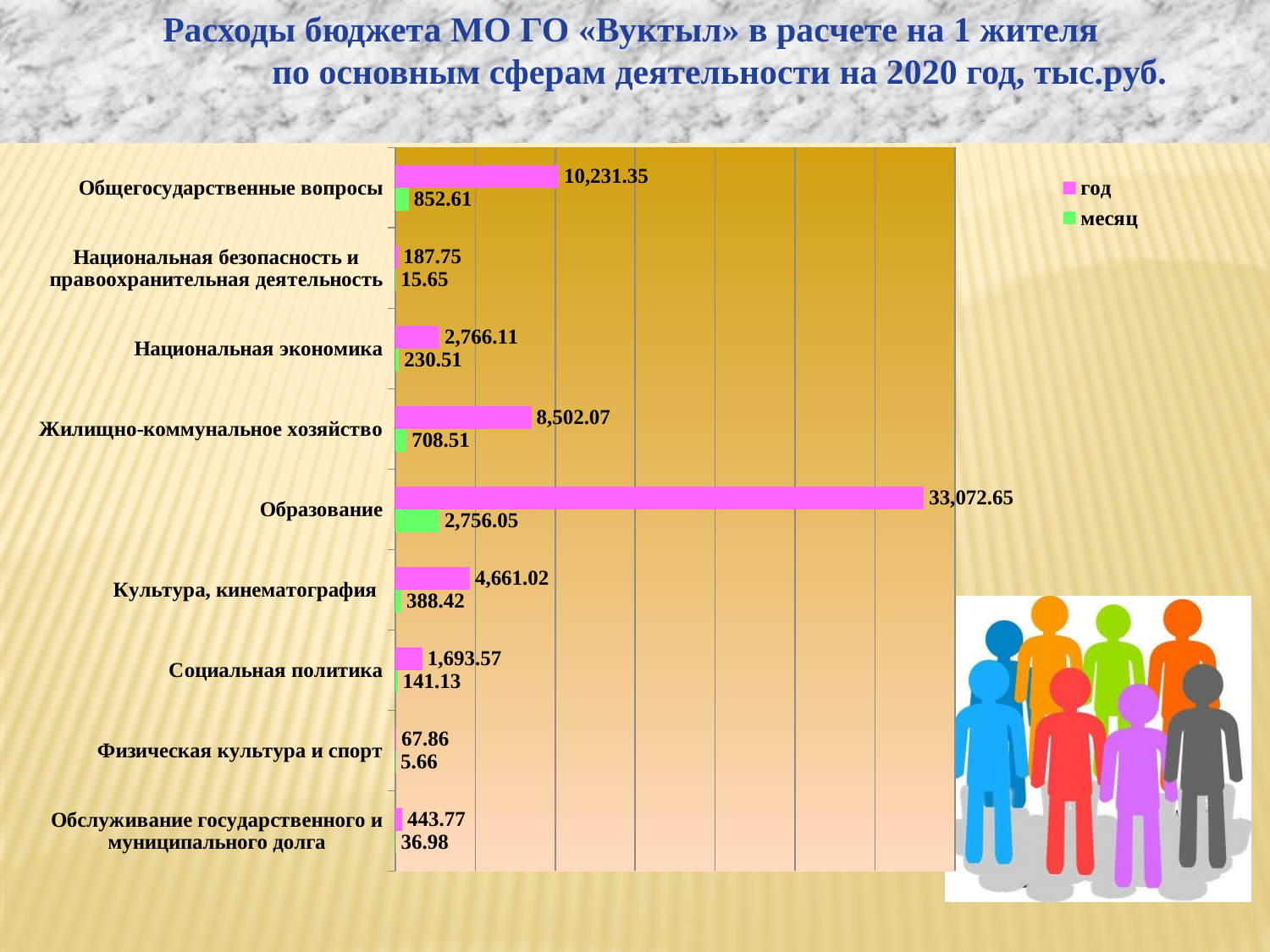
What is the value of the "месяц" series for Жилищно-коммунальное хозяйство? 708.51 What is the value of the "год" series for Образование? 33,072.65 What is the "месяц" value for Физическая культура и спорт? 5.66 What colour represents the "месяц" series in the legend? Green How many series does the legend list? 2 Which category has the lowest "месяц" value? Физическая культура и спорт What type of chart is shown on the slide? Bar chart What is the difference between the "год" values for Общегосударственные вопросы and Жилищно-коммунальное хозяйство? 1,729.28 What is the "год" value for Культура, кинематография? 4,661.02 Which is larger: the "год" value for Национальная экономика or for Социальная политика? Национальная экономика Which category has the highest "год" value? Образование How many categories are shown on the chart? 9